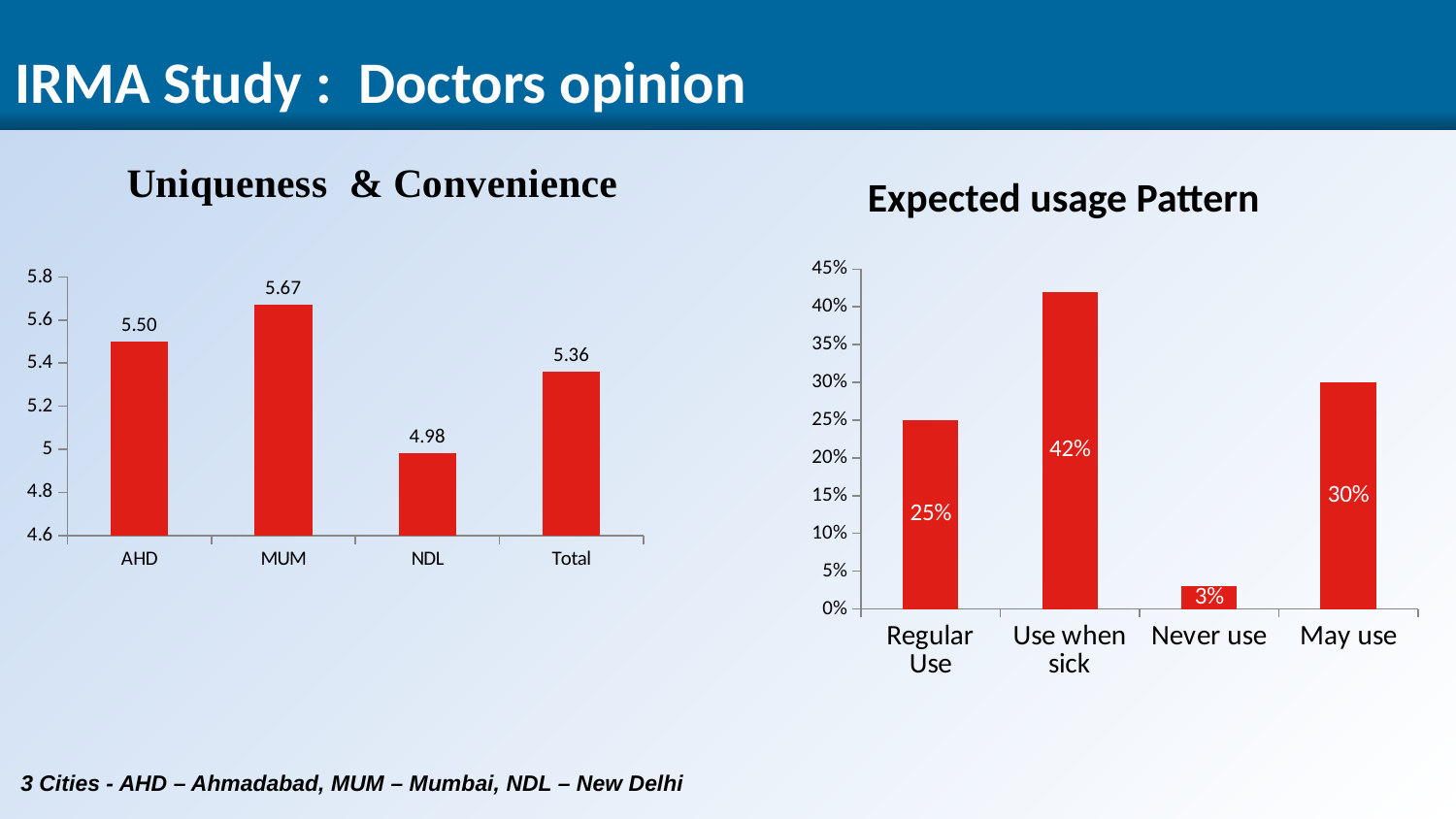
In the Uniqueness & Convenience chart, what is the difference between the values for AHD and NDL? 0.52 In the Expected usage Pattern chart, which is larger, the value for Regular Use or the value for May use? May use In the Uniqueness & Convenience chart, how many categories are shown on the x axis? 4 In the Uniqueness & Convenience chart, which category has the lowest value? NDL In the Expected usage Pattern chart, which category has the highest value? Use when sick In the Expected usage Pattern chart, what is the value for Never use? 3% In the Uniqueness & Convenience chart, what is the value for MUM? 5.67 In the Expected usage Pattern chart, what is the value for Use when sick? 42% In the Uniqueness & Convenience chart, what is the value for NDL? 4.98 In the Expected usage Pattern chart, what is the difference between the values for Use when sick and Regular Use? 17% In the Uniqueness & Convenience chart, which category has the highest value? MUM What kind of chart is the Expected usage Pattern chart? Bar chart